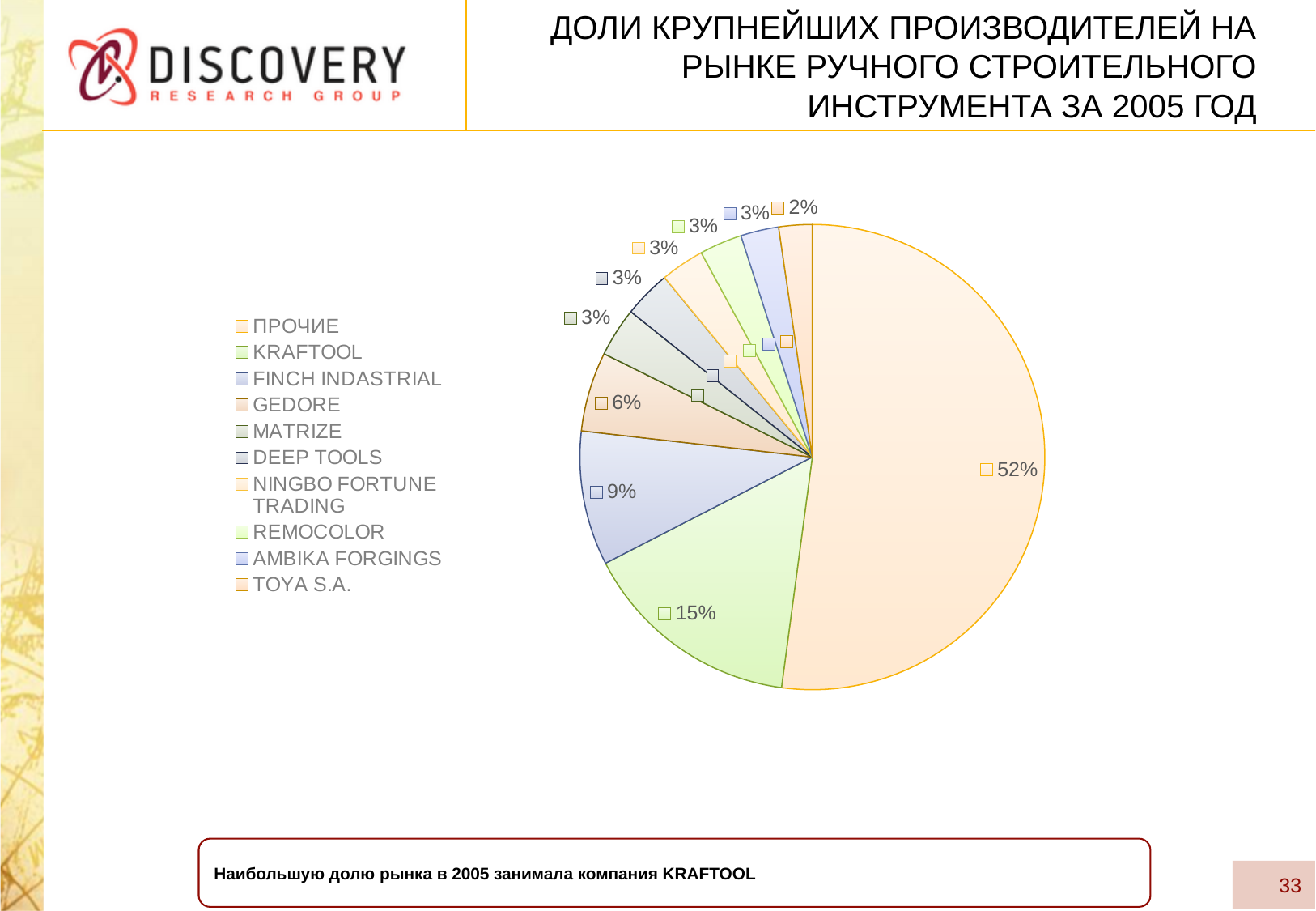
What is the difference between the shares of KRAFTOOL and FINCH INDASTRIAL? 6% What share of the market does ПРОЧИЕ hold in the pie chart? 52% What share is shown for GEDORE? 6% How many categories does the legend of the pie chart list? 10 What share is shown for FINCH INDASTRIAL? 9% What share of the market does KRAFTOOL hold? 15% Which category has the smallest slice of the pie? TOYA S.A. What type of chart is shown on the slide? pie chart Which category has the largest slice of the pie? ПРОЧИЕ What share is shown for TOYA S.A.? 2% Which company does the note at the bottom of the slide say held the largest market share in 2005? KRAFTOOL Which has a larger share, GEDORE or FINCH INDASTRIAL? FINCH INDASTRIAL